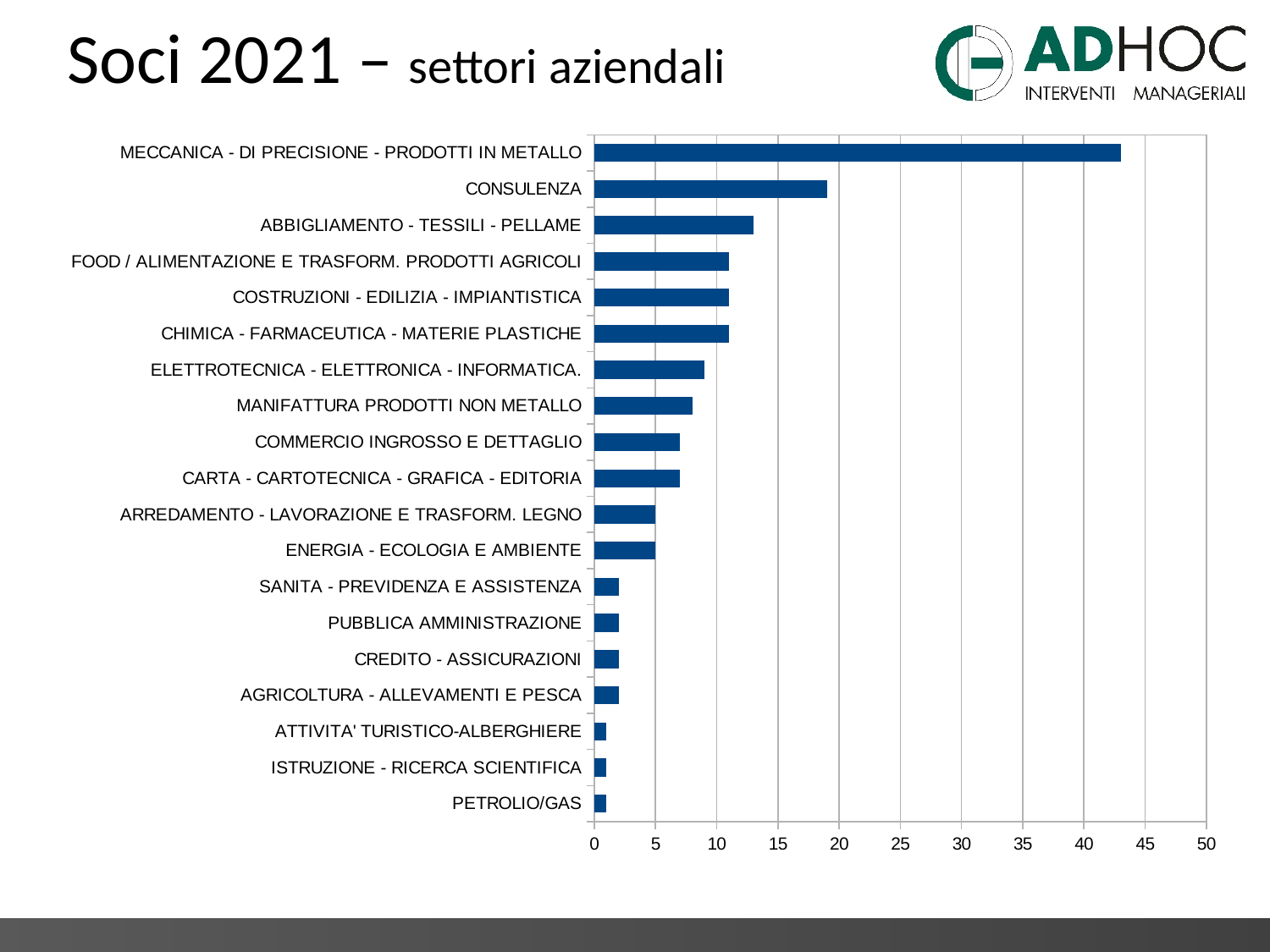
Is the value for MECCANICA - DI PRECISIONE - PRODOTTI IN METALLO greater or less than 40? greater What kind of chart is shown on the slide? bar chart Is the value for PETROLIO/GAS greater or less than 5? less Which sector has the highest value in the chart? MECCANICA - DI PRECISIONE - PRODOTTI IN METALLO What is the title of the slide containing the chart? Soci 2021 – settori aziendali Is the value for COMMERCIO INGROSSO E DETTAGLIO greater or less than 10? less Which is larger, the value for ELETTROTECNICA - ELETTRONICA - INFORMATICA. or the value for SANITA - PREVIDENZA E ASSISTENZA? ELETTROTECNICA - ELETTRONICA - INFORMATICA. How many sectors (categories) are listed in the chart? 19 Which is larger, the value for CONSULENZA or the value for ABBIGLIAMENTO - TESSILI - PELLAME? CONSULENZA What is the maximum value shown on the horizontal axis of the chart? 50